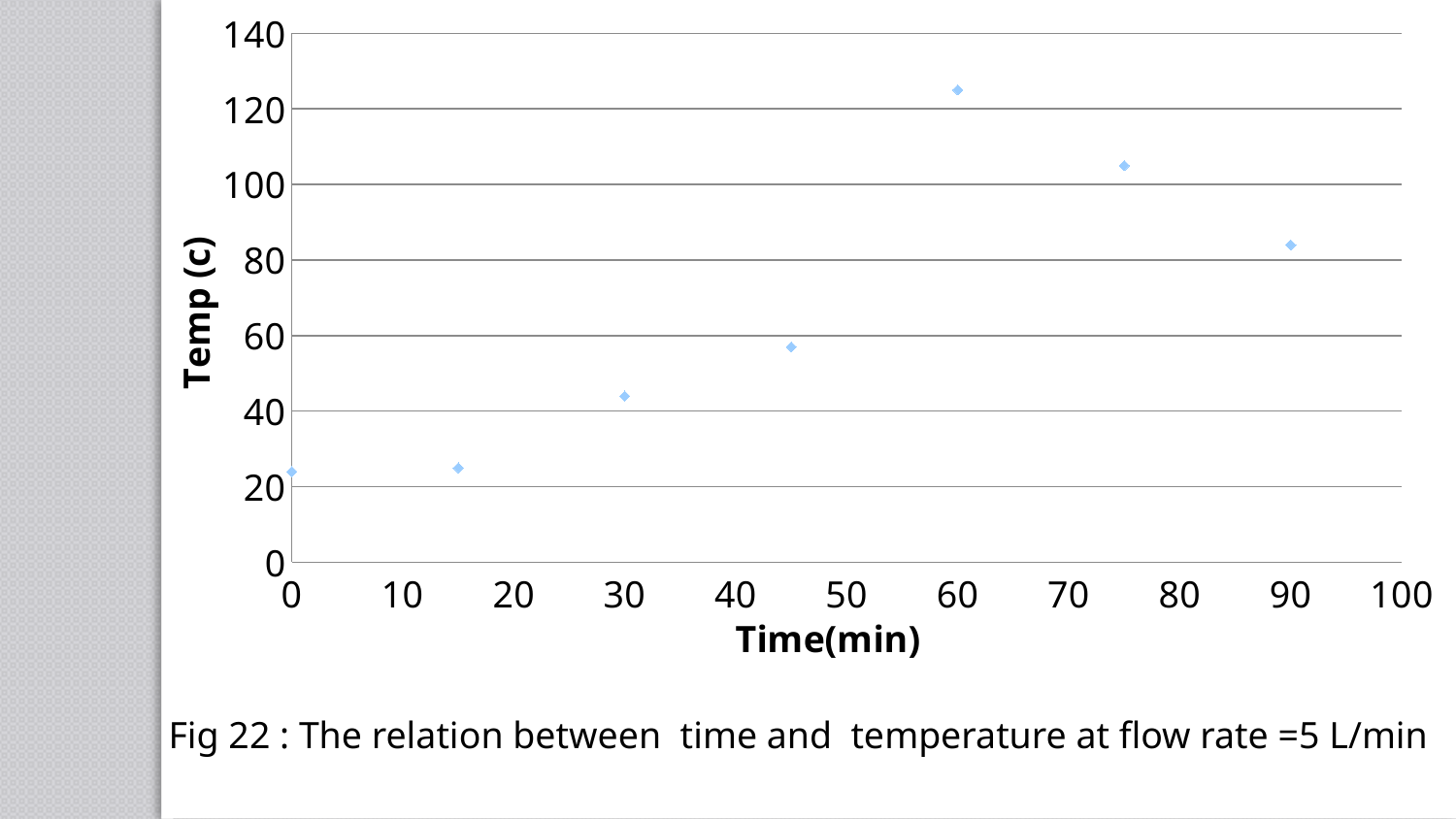
Which has the higher temperature, 60 min or 90 min? 60 min At which time (min) is the temperature highest? 60 What kind of chart is shown on the slide? scatter chart Which has the higher temperature, 30 min or 75 min? 75 min Is the temperature at 60 min greater or less than 120? greater Is the temperature at 90 min greater or less than 100? less Does the temperature rise or fall between 0 min and 60 min? rise Is the temperature at 45 min greater or less than 40? greater What is the label of the x axis? Time(min) How many data points are plotted on the chart? 7